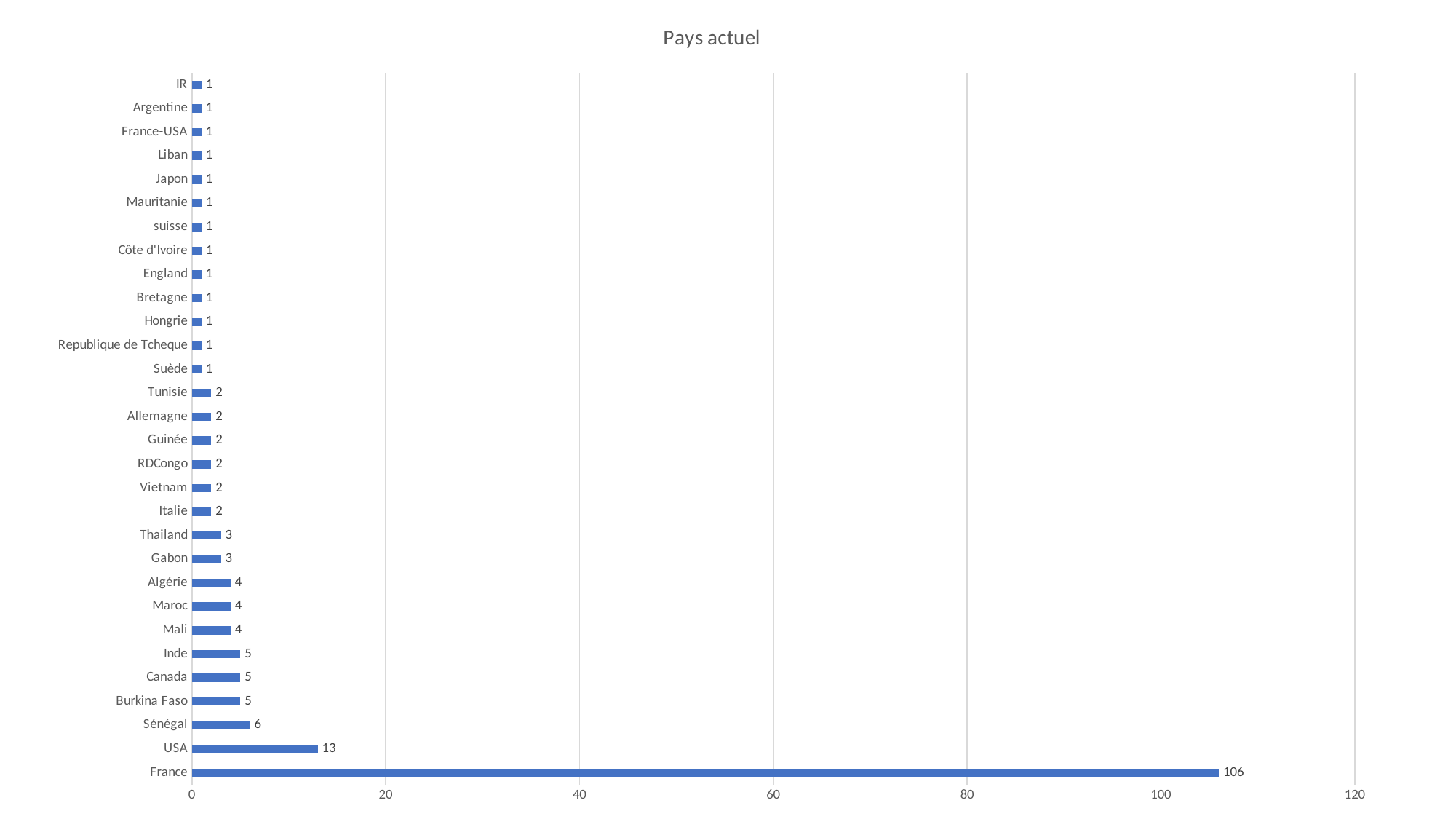
What is the title of the chart? Pays actuel What kind of chart is this? bar chart What is the value for USA? 13 Which is larger, the value for Inde or the value for Thailand? Inde What is the difference between the values for France and USA? 93 Which country has the highest value? France How many countries are shown in the chart? 30 Is the value for France greater or less than 100? greater What is the value for Algérie? 4 What is the value for Sénégal? 6 What is the difference between the values for Sénégal and Gabon? 3 What is the value for France? 106